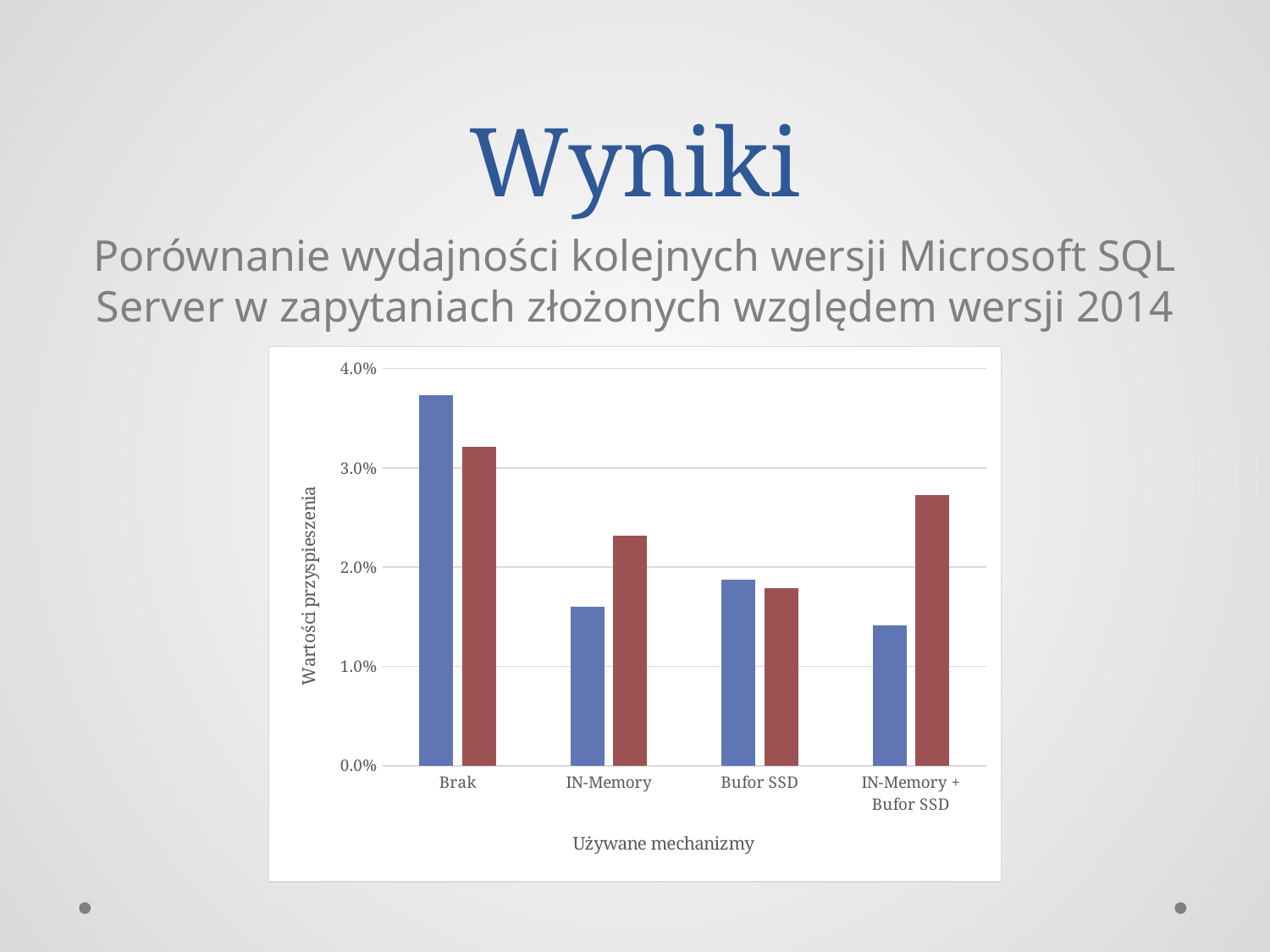
Is the blue bar for IN-Memory greater or less than 2.0%? less For IN-Memory + Bufor SSD, which bar is taller, the blue one or the red one? the red one What is the title of the x axis of the chart? Używane mechanizmy Is the blue bar for Brak greater or less than 3.0%? greater Which category has the tallest blue bar? Brak Which category has the shortest red bar? Bufor SSD For Brak, which bar is taller, the blue one or the red one? the blue one Is the red bar for IN-Memory + Bufor SSD greater or less than 2.0%? greater Which category has the shortest blue bar? IN-Memory + Bufor SSD Which category has the tallest red bar? Brak How many categories are shown on the x axis of the chart? 4 What kind of chart is shown on the slide? bar chart